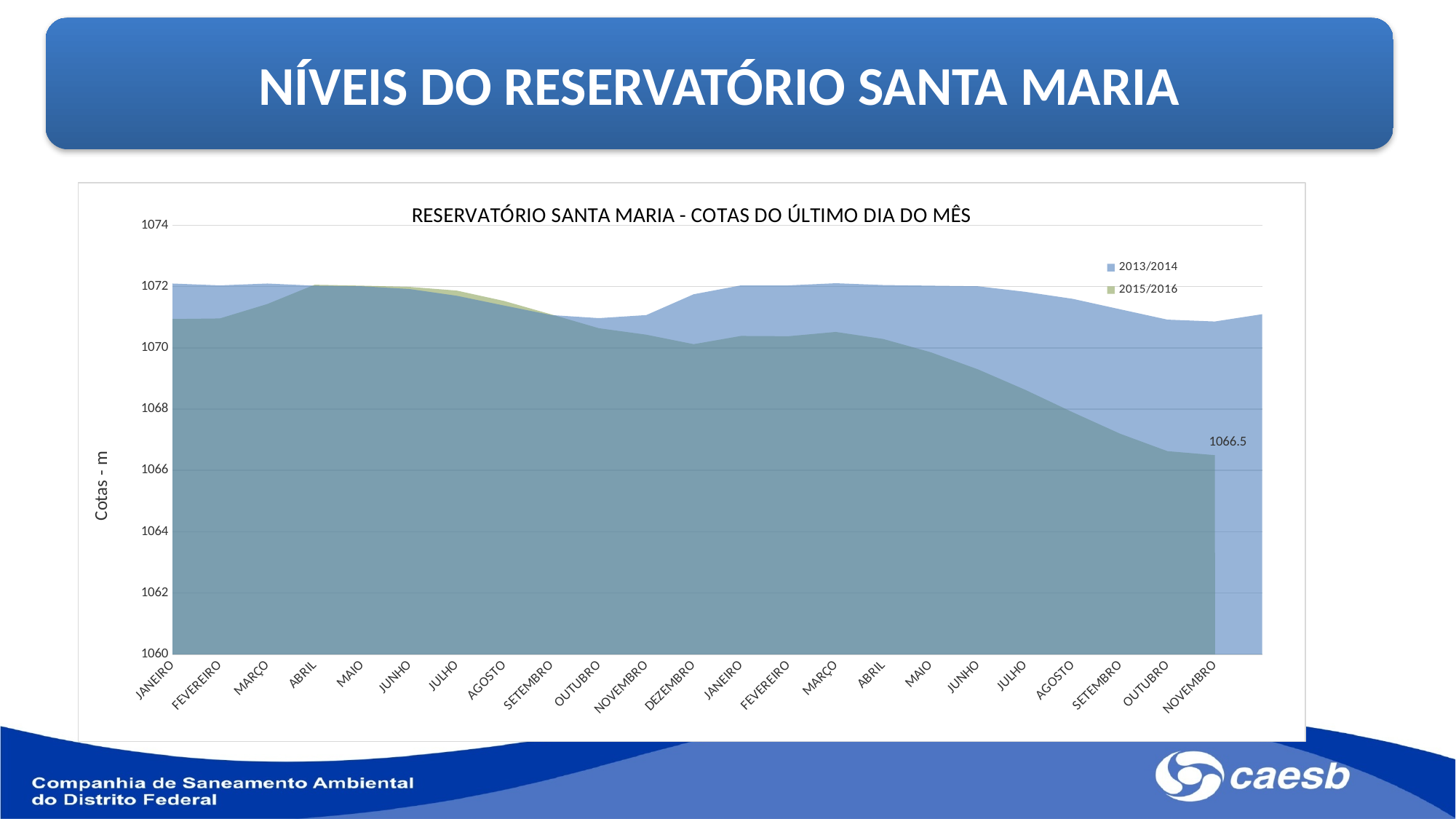
What is the title of the chart? RESERVATÓRIO SANTA MARIA - COTAS DO ÚLTIMO DIA DO MÊS Is the value for the 2015/2016 series at the second MAIO greater or less than 1068? greater What kind of chart is shown on the slide? Area chart How many series does the legend list? 2 At the final NOVEMBRO, which series has the higher value, 2013/2014 or 2015/2016? 2013/2014 At which month does the 2015/2016 series reach its lowest value? NOVEMBRO (second year) What is the label of the vertical axis? Cotas - m Does the 2015/2016 series rise or fall from the second MARÇO to the final NOVEMBRO? Fall Is the value for the 2013/2014 series at the first JANEIRO greater or less than 1070? greater What value is labelled for the 2015/2016 series at the final NOVEMBRO point? 1066.5 Is the value for the 2015/2016 series at the first JANEIRO greater or less than 1070? greater